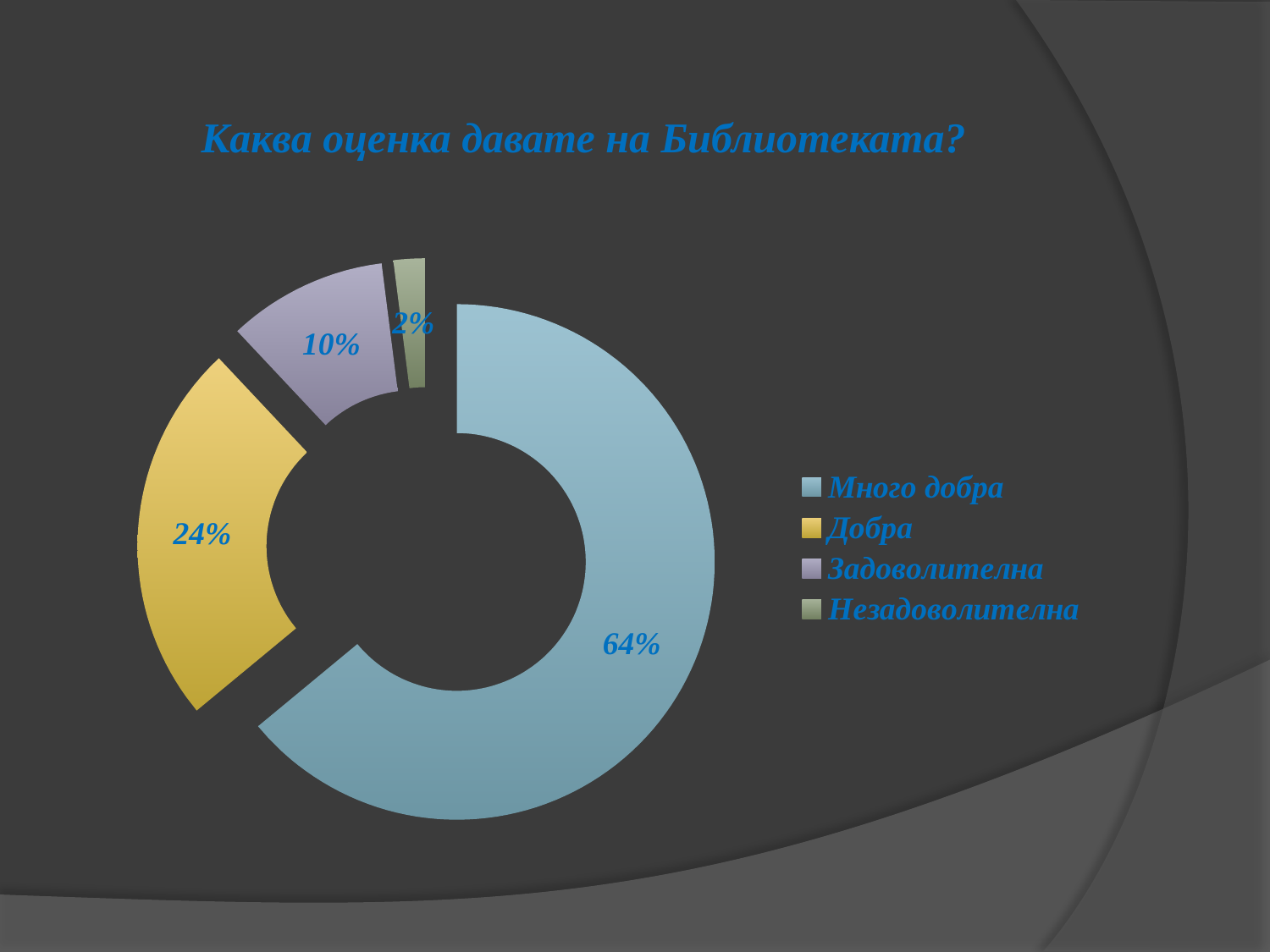
What share of the chart does the 'Много добра' slice represent? 64% What is the title of the chart? Каква оценка давате на Библиотеката? What is the value shown for 'Задоволителна'? 10% What is the difference between the shares of 'Много добра' and 'Добра'? 40% How many categories does the chart show? 4 What is the value shown for 'Незадоволителна'? 2% What kind of chart is shown on the slide? Doughnut (pie) chart Which category has the smallest share? Незадоволителна Which is larger, the share for 'Добра' or for 'Задоволителна'? Добра What is the difference between the shares of 'Задоволителна' and 'Незадоволителна'? 8% Which category has the largest share? Много добра What is the value shown for 'Добра'? 24%